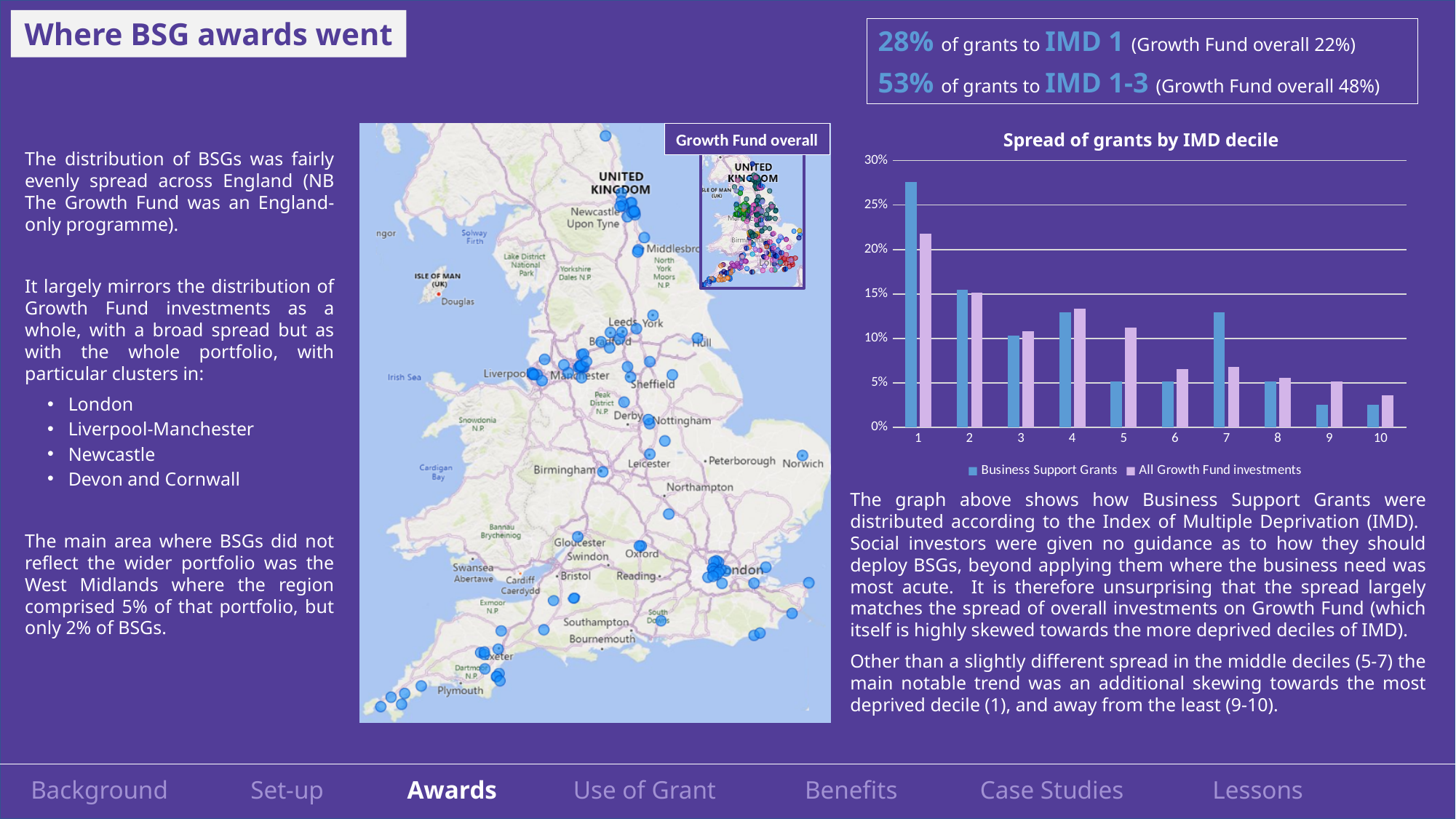
In the 'Spread of grants by IMD decile' chart, which decile has the highest value for Business Support Grants? 1 How many series does the legend of the 'Spread of grants by IMD decile' chart list? 2 In the 'Spread of grants by IMD decile' chart, is the Business Support Grants value for decile 9 greater or less than 5%? less In the 'Spread of grants by IMD decile' chart, which decile has the lowest value for All Growth Fund investments? 10 How many IMD deciles are shown on the x axis of the 'Spread of grants by IMD decile' chart? 10 What kind of chart is 'Spread of grants by IMD decile'? bar chart In the 'Spread of grants by IMD decile' chart, is the All Growth Fund investments value for decile 5 greater or less than 10%? greater In the 'Spread of grants by IMD decile' chart, is the Business Support Grants value for decile 1 greater or less than 25%? greater In the 'Spread of grants by IMD decile' chart, do the Business Support Grants values generally rise or fall from decile 1 to decile 10? fall What are the two legend entries in the 'Spread of grants by IMD decile' chart? Business Support Grants; All Growth Fund investments In the 'Spread of grants by IMD decile' chart, which series has the larger value for decile 5? All Growth Fund investments In the 'Spread of grants by IMD decile' chart, which series has the larger value for decile 7? Business Support Grants